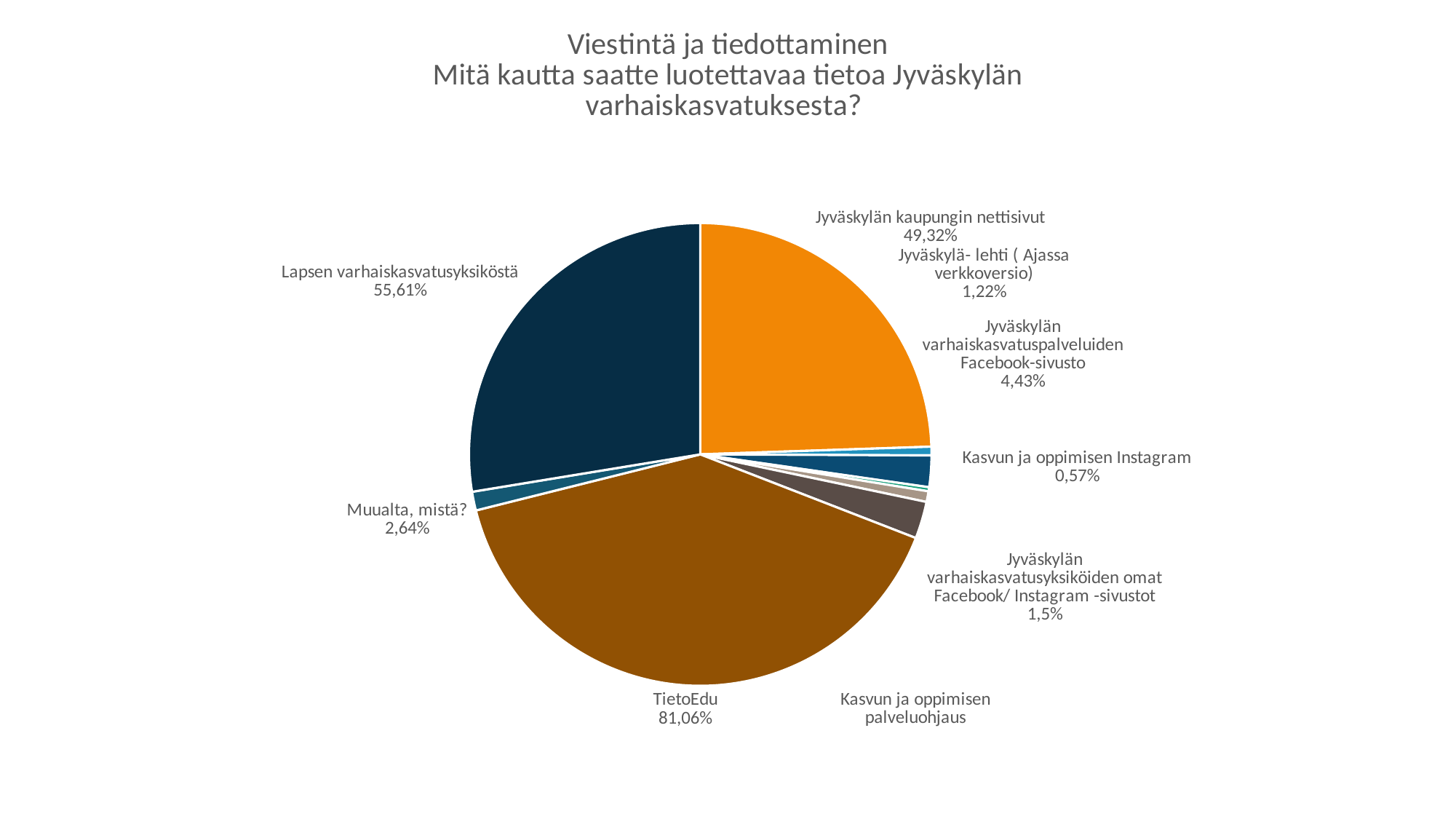
Which labelled category has the lowest printed value in the pie chart? Kasvun ja oppimisen Instagram Which category has the highest value in the pie chart? TietoEdu What is the value shown for Kasvun ja oppimisen Instagram? 0,57% What kind of chart is shown on the slide? pie chart What is the first line of the chart title? Viestintä ja tiedottaminen What is the value shown for Lapsen varhaiskasvatusyksiköstä? 55,61% Which is larger: the value for Muualta, mistä? or the value for Jyväskylä- lehti ( Ajassa verkkoversio)? Muualta, mistä? What is the value shown for TietoEdu? 81,06% How many categories are labelled in the pie chart? 9 What is the difference between the values for TietoEdu and Lapsen varhaiskasvatusyksiköstä? 25,45% What is the value shown for Muualta, mistä? 2,64% What is the value shown for Jyväskylän kaupungin nettisivut? 49,32%